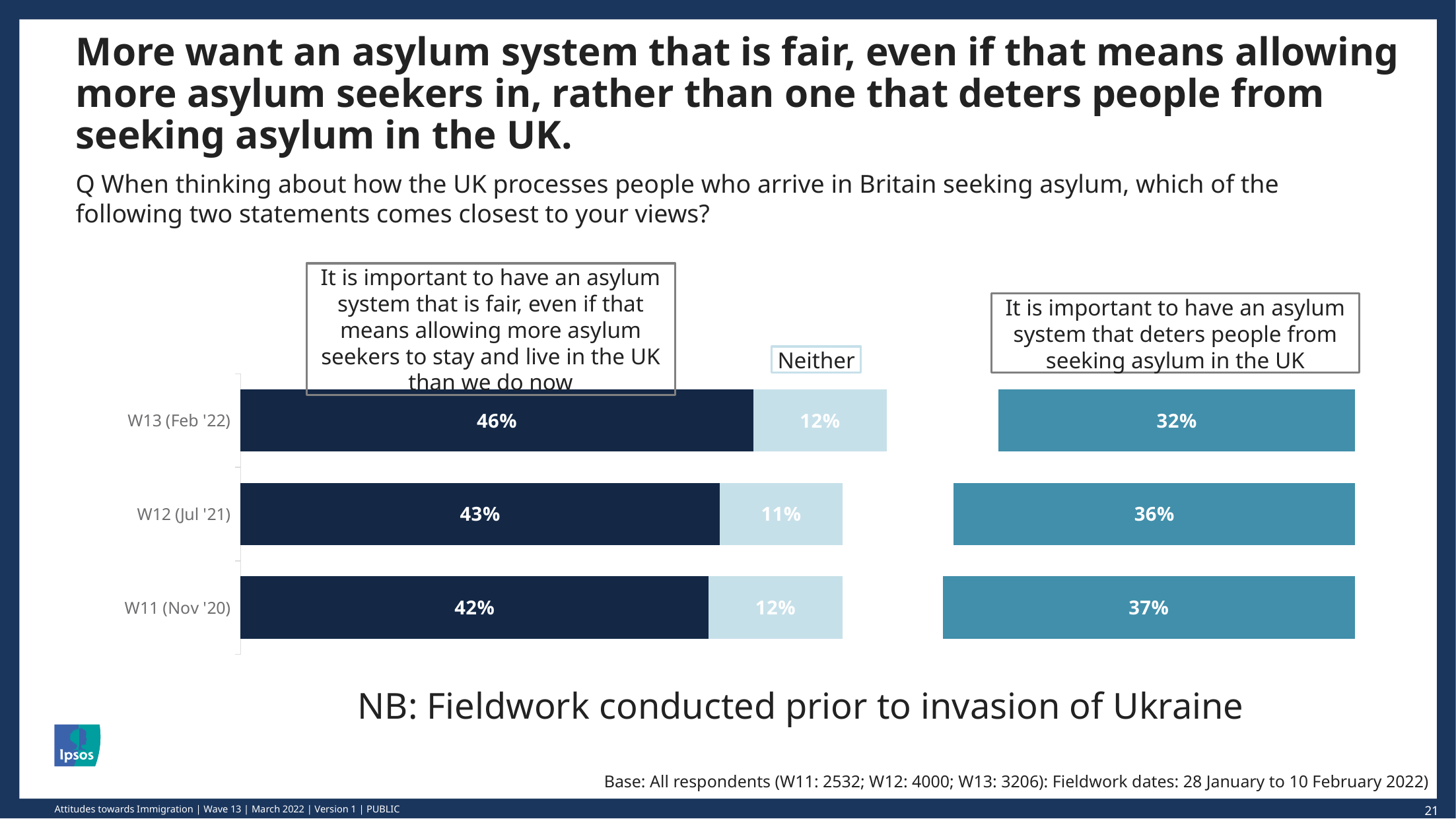
What percentage of respondents in W11 (Nov '20) said it is important to have an asylum system that deters people from seeking asylum in the UK? 37% What is the difference between the share choosing the 'fair' statement and the share choosing the 'deters' statement in W13 (Feb '22)? 14 percentage points In which wave was the share choosing the 'deters people' statement lowest? W13 (Feb '22) How many survey waves are shown on the chart? 3 What percentage of respondents in W12 (Jul '21) answered 'Neither'? 11% What type of chart is shown on the slide? Bar chart In which wave was the share choosing the 'fair' asylum system statement highest? W13 (Feb '22) Which response option is shown in the lightest blue colour? Neither How did the share choosing the 'deters people' statement change from W11 (Nov '20) to W13 (Feb '22)? It fell, from 37% to 32% How many response options (series) are shown on the chart? 3 What percentage of respondents in W13 (Feb '22) said it is important to have an asylum system that is fair, even if that means allowing more asylum seekers to stay? 46% In W12 (Jul '21), which was larger: the share choosing the 'fair' statement or the share choosing the 'deters' statement? The 'fair' statement (43%)